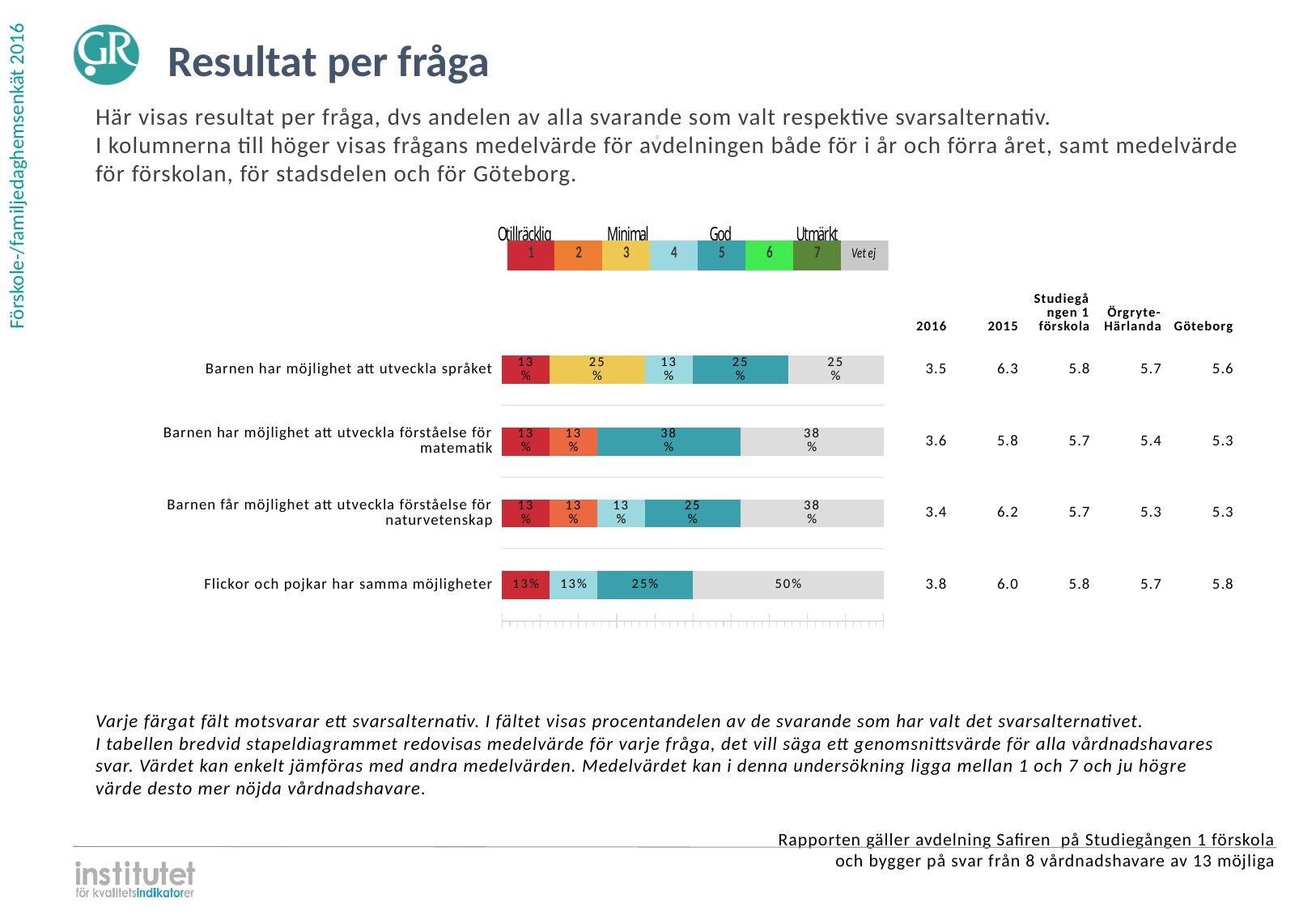
What kind of chart is used to show the results per question? Stacked bar chart How many questions (categories) are shown as bars in the chart? 4 What percentage chose response option 3 (yellow) for 'Barnen har möjlighet att utveckla språket'? 25% What percentage of respondents answered 'Vet ej' for 'Flickor och pojkar har samma möjligheter'? 50% Which is larger for 'Barnen får möjlighet att utveckla förståelse för naturvetenskap': the share for option 5 (teal) or the share for option 1 (red)? Option 5 (teal) What is the 2016 mean value for 'Flickor och pojkar har samma möjligheter'? 3.8 What is the 2015 mean value for 'Barnen har möjlighet att utveckla språket'? 6.3 Which question has the lowest 2016 mean value in the table? Barnen får möjlighet att utveckla förståelse för naturvetenskap How many response options does the legend above the chart list, including 'Vet ej'? 8 What is the difference between the 'Vet ej' share for 'Flickor och pojkar har samma möjligheter' and for 'Barnen har möjlighet att utveckla språket'? 25% What percentage chose response option 5 (teal) for 'Barnen har möjlighet att utveckla förståelse för matematik'? 38% Which question has the largest 'Vet ej' share? Flickor och pojkar har samma möjligheter